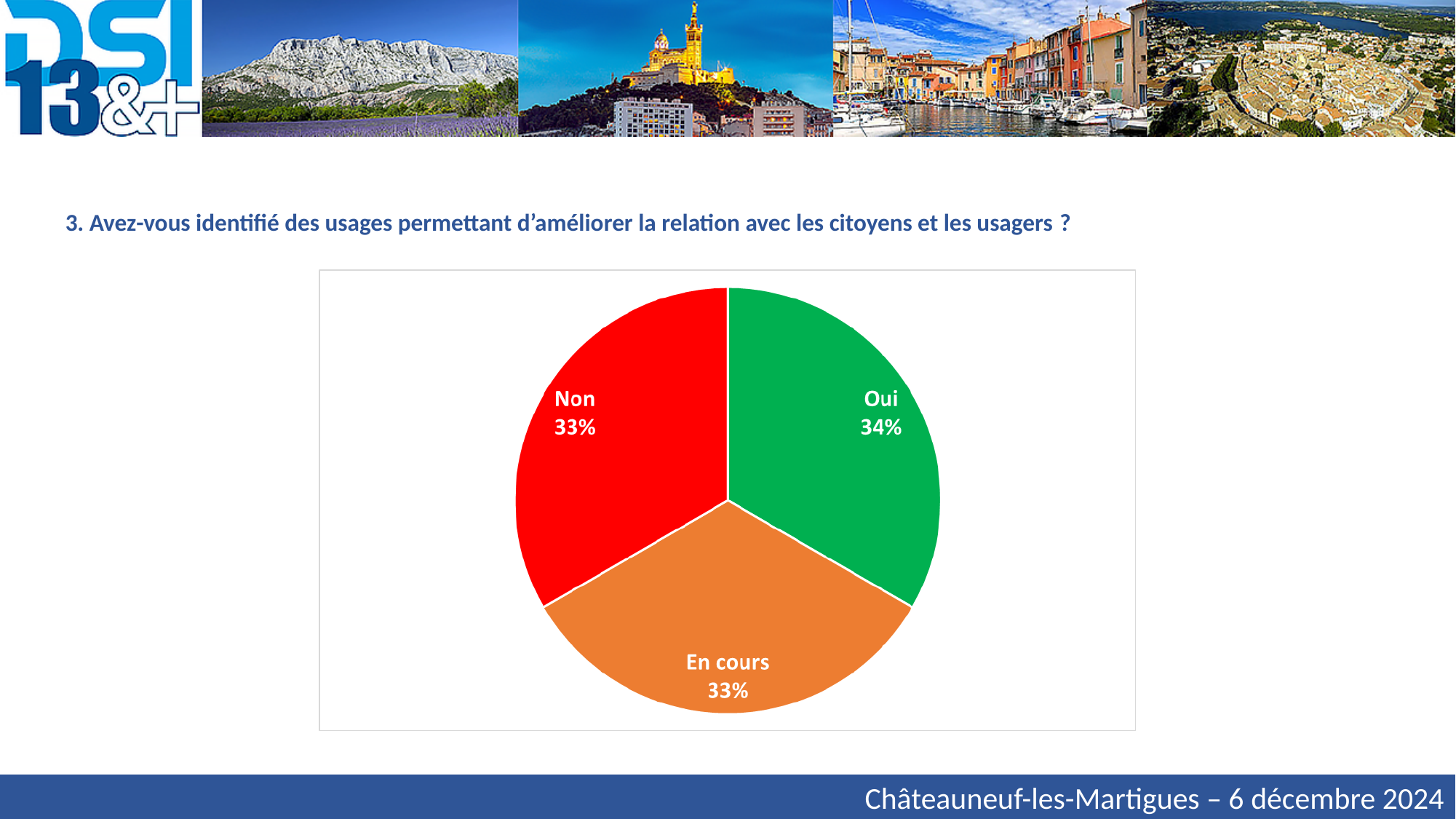
What share of the pie does the "Non" slice represent? 33% What colour is the "En cours" slice? orange What kind of chart is shown on the slide? pie chart Which is larger, the "Oui" slice or the "Non" slice? Oui Is the value for "Oui" greater or less than 30%? greater How many slices does the pie chart have? 3 Which slice of the pie chart is the largest? Oui What share of the pie does the "En cours" slice represent? 33% What share of the pie does the "Oui" slice represent? 34% What colour is the "Non" slice? red What is the difference in percentage points between the "Oui" slice and the "En cours" slice? 1%